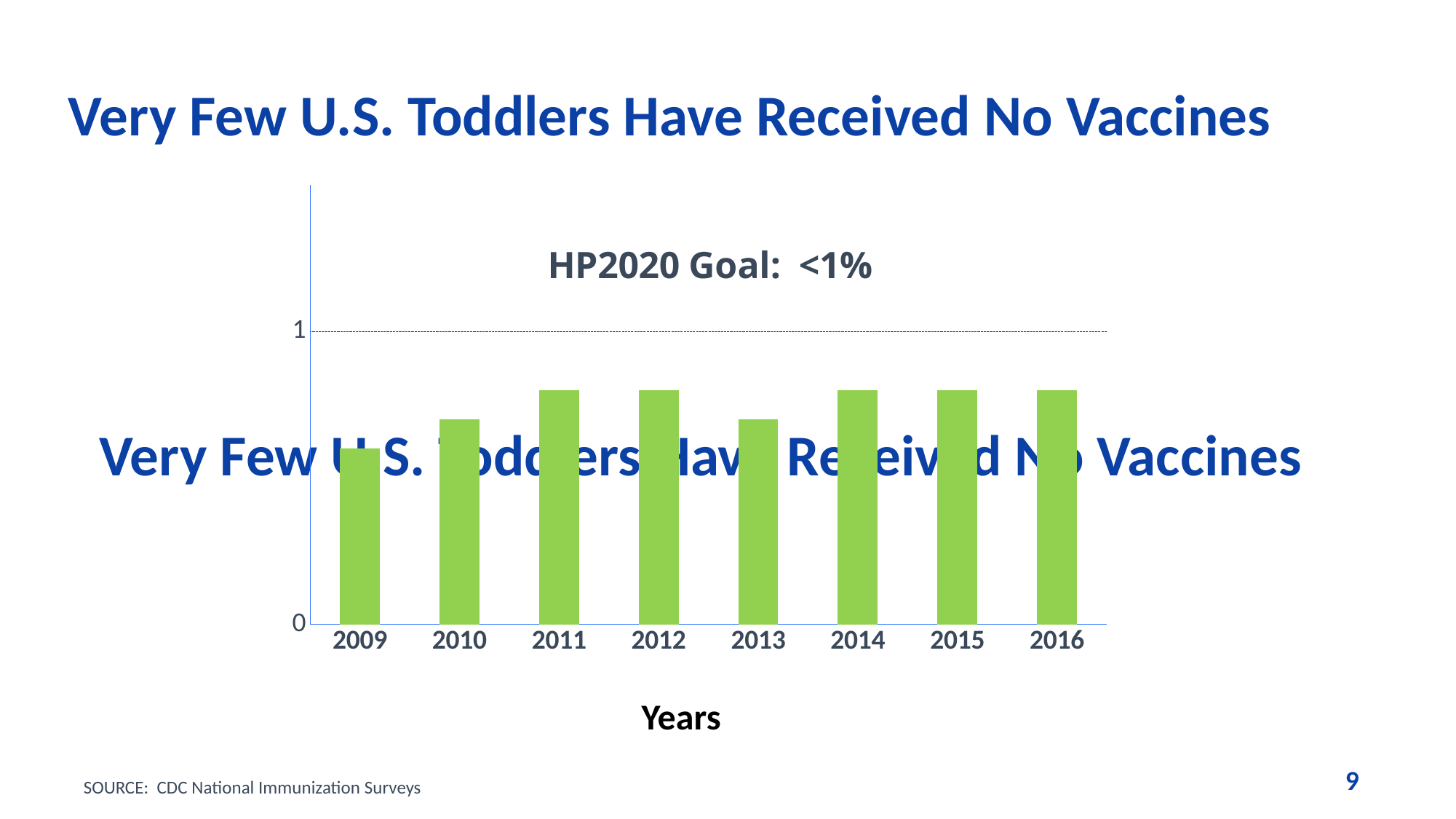
What kind of chart is shown on the slide? bar chart What HP2020 goal is stated on the chart? <1% Is the value for 2012 greater or less than 1? less Which year has the larger value, 2013 or 2014? 2014 Is the value for 2009 greater or less than 1? less Which year has the lowest bar in the chart? 2009 Which year has the larger value, 2009 or 2010? 2010 What is the title of the x axis of the chart? Years Which year has the larger value, 2009 or 2011? 2011 Is the value for 2016 greater or less than 1? less How many years are shown on the x axis of the chart? 8